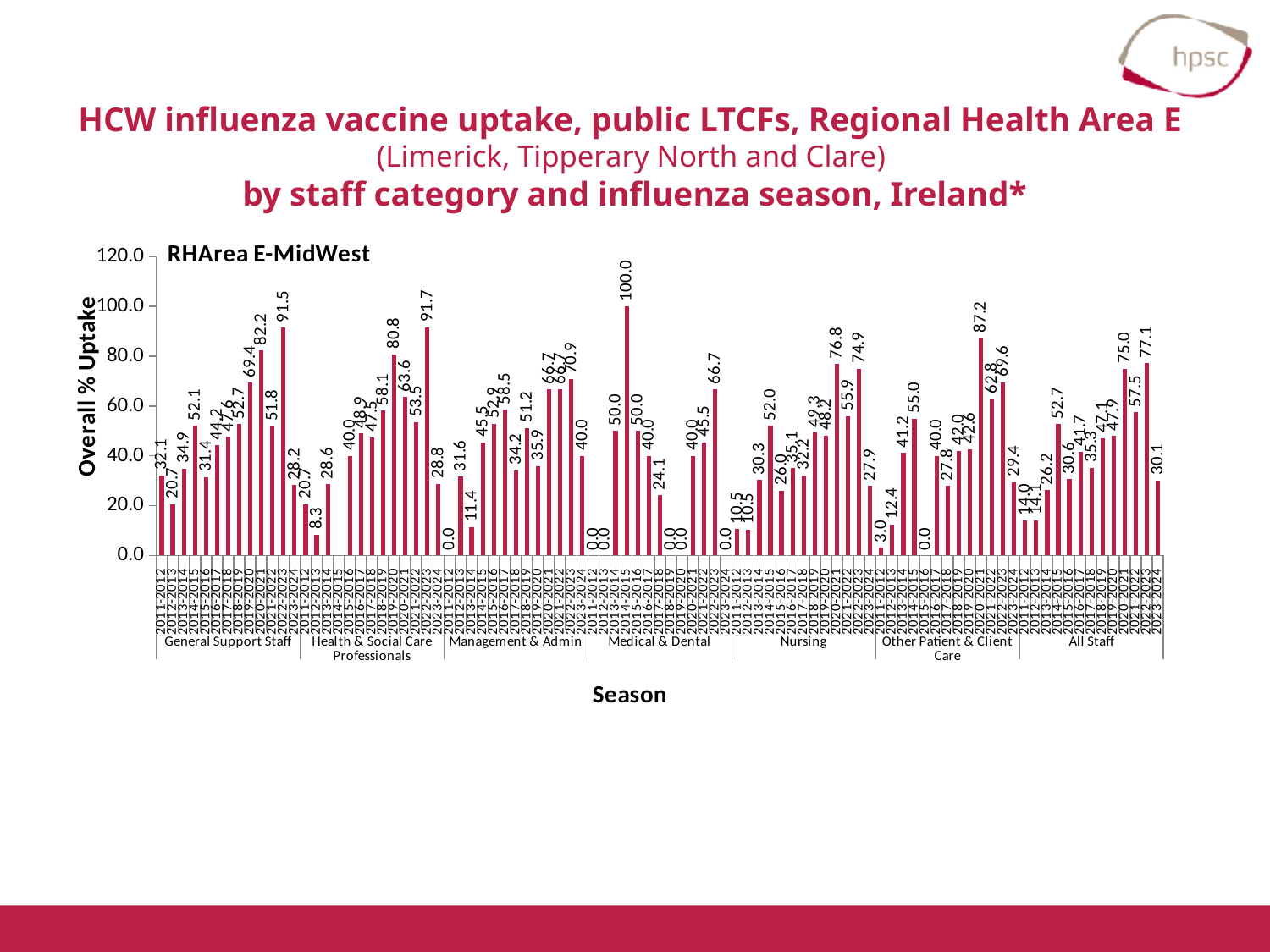
What is the uptake value for General Support Staff in the 2022-2023 season? 91.5 What is the uptake value for Other Patient & Client Care in the 2020-2021 season? 87.2 What is the label on the vertical axis of the chart? Overall % Uptake What is the title printed inside the chart area? RHArea E-MidWest In the 2020-2021 season, which is larger: the Nursing value or the Other Patient & Client Care value? Other Patient & Client Care What is the uptake value for Medical & Dental in the 2014-2015 season? 100.0 What type of chart is shown on the slide? bar chart What is the difference between the All Staff values for 2022-2023 and 2023-2024? 47.0 How many staff categories are shown along the x axis? 7 Which season has the highest uptake value within the All Staff group? 2022-2023 What is the uptake value for All Staff in the 2023-2024 season? 30.1 Which staff category and season has the highest uptake value in the chart? Medical & Dental, 2014-2015